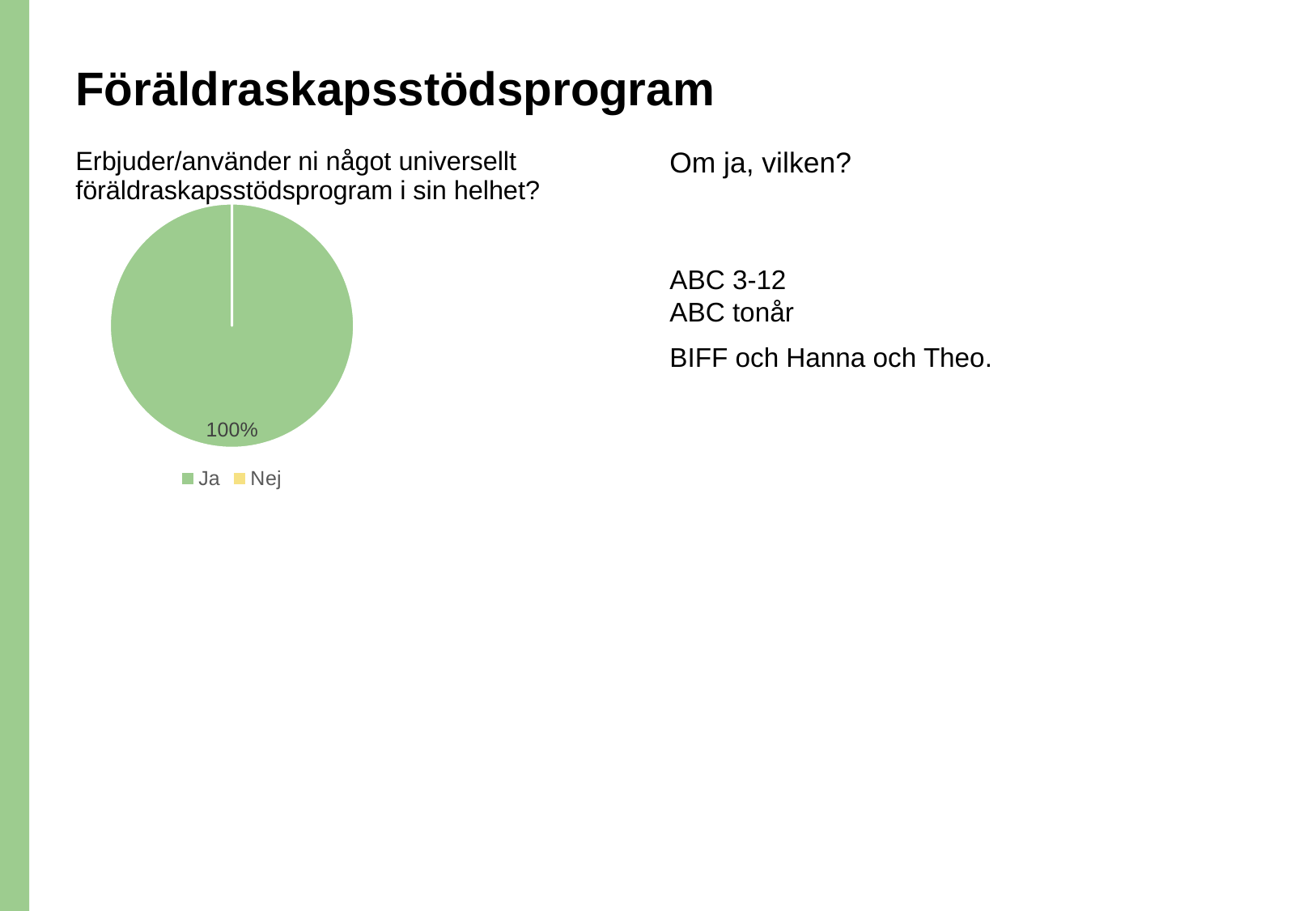
What are the two categories listed in the legend of the pie chart? Ja and Nej What colour represents "Ja" in the pie chart? green What value is printed on the pie chart for "Ja"? 100% How many entries does the legend of the pie chart list? 2 Which category has the smallest share of the pie chart? Nej What share of the pie does "Ja" represent? 100% What kind of chart is shown on the slide? pie chart Which category has the largest share of the pie chart? Ja Which is larger in the pie chart, "Ja" or "Nej"? Ja